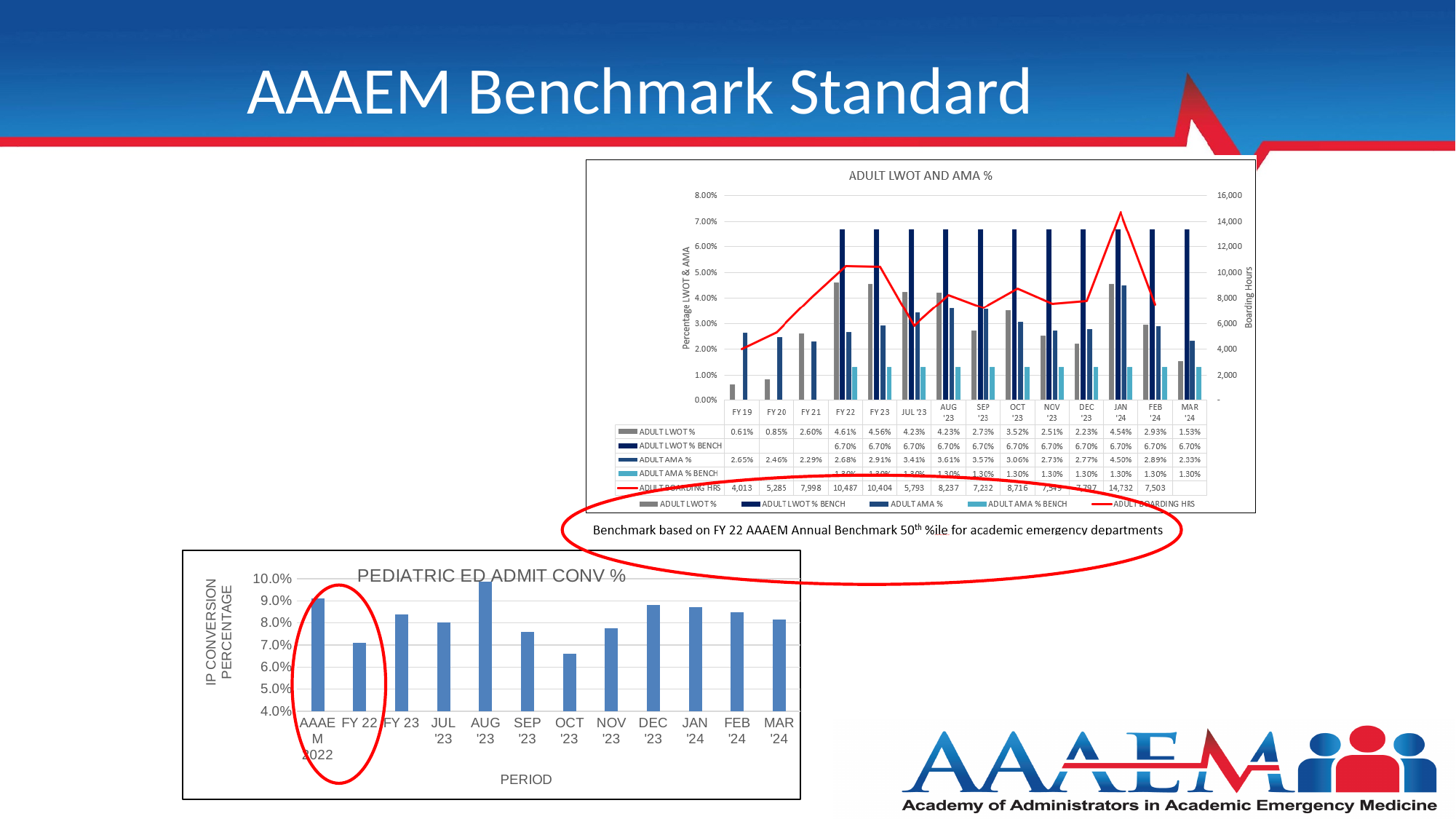
How many series does the legend of the ADULT LWOT AND AMA % chart list? 5 In the ADULT LWOT AND AMA % chart, which is larger for SEP '23: ADULT LWOT % or ADULT AMA %? ADULT AMA % What kind of chart is the PEDIATRIC ED ADMIT CONV % chart? bar chart In the PEDIATRIC ED ADMIT CONV % chart, which period has the highest value? AUG '23 In the ADULT LWOT AND AMA % chart, what is the difference between the ADULT LWOT % BENCH and the ADULT LWOT % for MAR '24? 5.17% In the ADULT LWOT AND AMA % chart, what is the ADULT AMA % value for JAN '24? 4.50% In the ADULT LWOT AND AMA % chart, which period has the lowest ADULT LWOT %? FY 19 In the PEDIATRIC ED ADMIT CONV % chart, is the value for FY 22 greater or less than 8.0%? less In the PEDIATRIC ED ADMIT CONV % chart, which period has the lowest value? OCT '23 How many periods are shown on the x axis of the ADULT LWOT AND AMA % chart? 14 In the ADULT LWOT AND AMA % chart, what is the ADULT BOARDING HRS value for JAN '24? 14,732 In the ADULT LWOT AND AMA % chart, what is the ADULT LWOT % value for FY 22? 4.61%